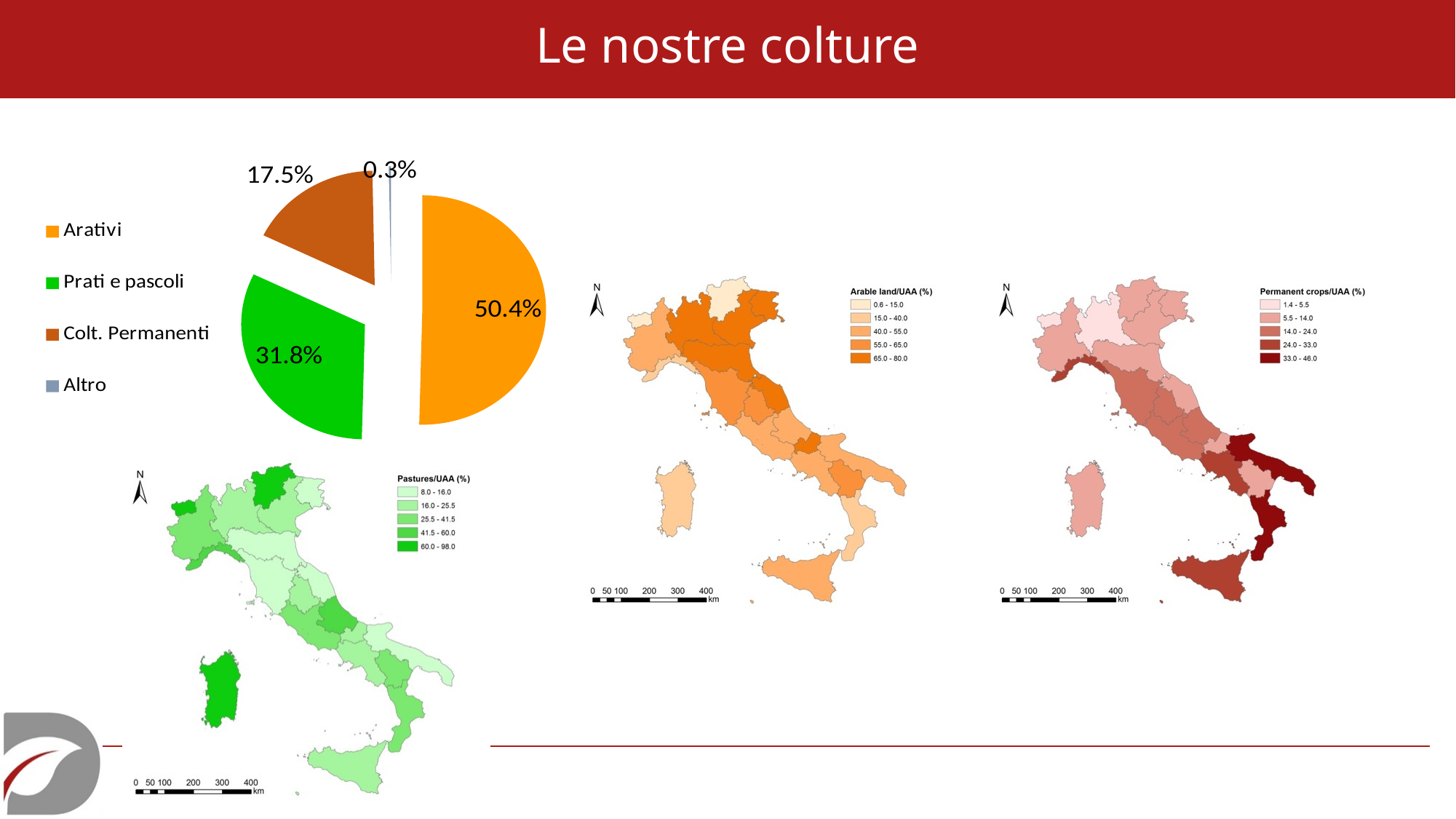
What share of the pie chart does Prati e pascoli represent? 31.8% Which category has the smallest slice in the pie chart? Altro What share of the pie chart does Arativi represent? 50.4% What is the difference in percentage points between Arativi and Prati e pascoli in the pie chart? 18.6 What share of the pie chart does Altro represent? 0.3% What is the difference in percentage points between Prati e pascoli and Colt. Permanenti in the pie chart? 14.3 In the pie chart, which is larger: Colt. Permanenti or Prati e pascoli? Prati e pascoli What colour is the Arativi slice in the pie chart? Orange How many categories does the pie chart legend list? 4 What share of the pie chart does Colt. Permanenti represent? 17.5% Which category has the largest slice in the pie chart? Arativi What type of chart is shown at the top left of the slide? Pie chart